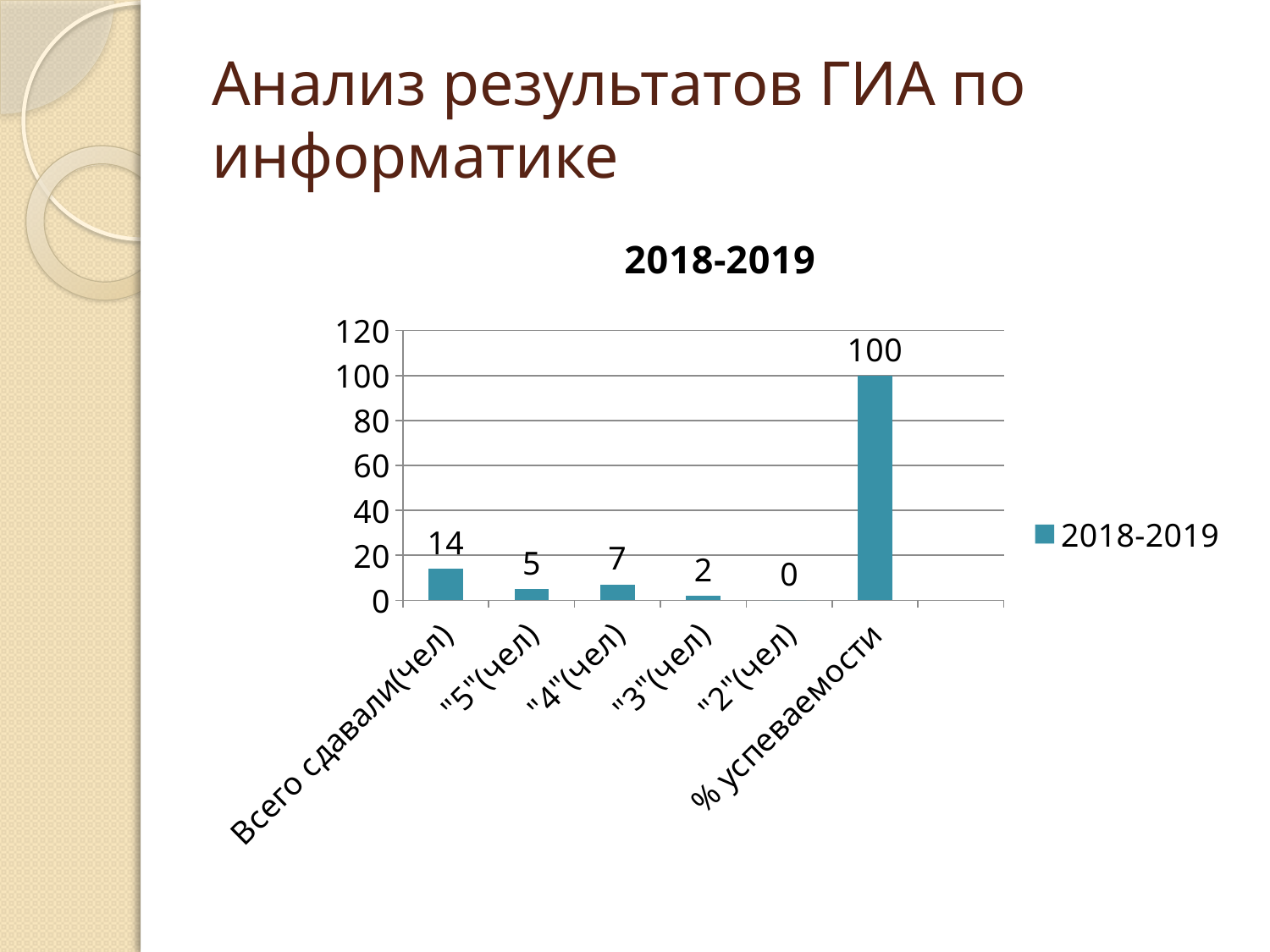
What is the value for ""4"(чел)"? 7 How many categories are shown on the x axis? 6 How many series does the legend list? 1 What kind of chart is shown on the slide? bar chart What is the value for ""5"(чел)"? 5 Which is larger, the value for ""5"(чел)" or the value for ""3"(чел)"? "5"(чел) Which category has the lowest value? "2"(чел) What is the value for ""2"(чел)"? 0 What is the difference between the values for ""4"(чел)" and ""5"(чел)"? 2 Which category has the highest value? % успеваемости What is the title of the chart? 2018-2019 What is the value for "Всего сдавали(чел)"? 14